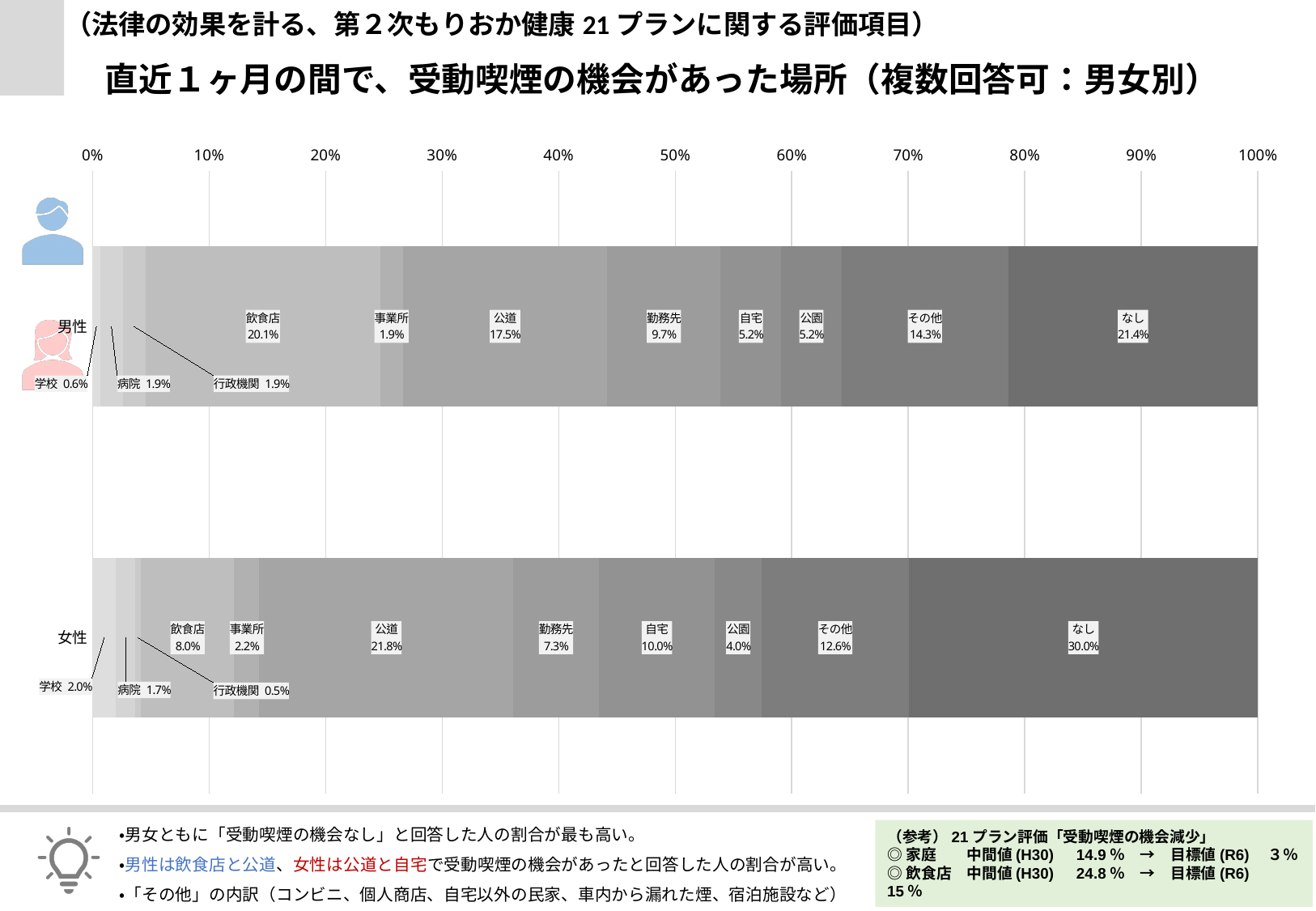
Which is larger, the 飲食店 value for 男性 or for 女性? 男性 What is the difference between the その他 values for 男性 and 女性? 1.7% How many bars (groups) does the chart show? 2 What kind of chart is shown on the slide? Stacked bar chart What is the value for 飲食店 in the 男性 bar? 20.1% What is the difference between the 自宅 values for 女性 and 男性? 4.8% How many categories (segments) are labelled in each bar? 11 What is the value for 公道 in the 女性 bar? 21.8% Which category has the lowest value in the 女性 bar? 行政機関 Which category has the highest value in the 男性 bar? なし What is the value for 学校 in the 男性 bar? 0.6% What is the value for なし in the 女性 bar? 30.0%